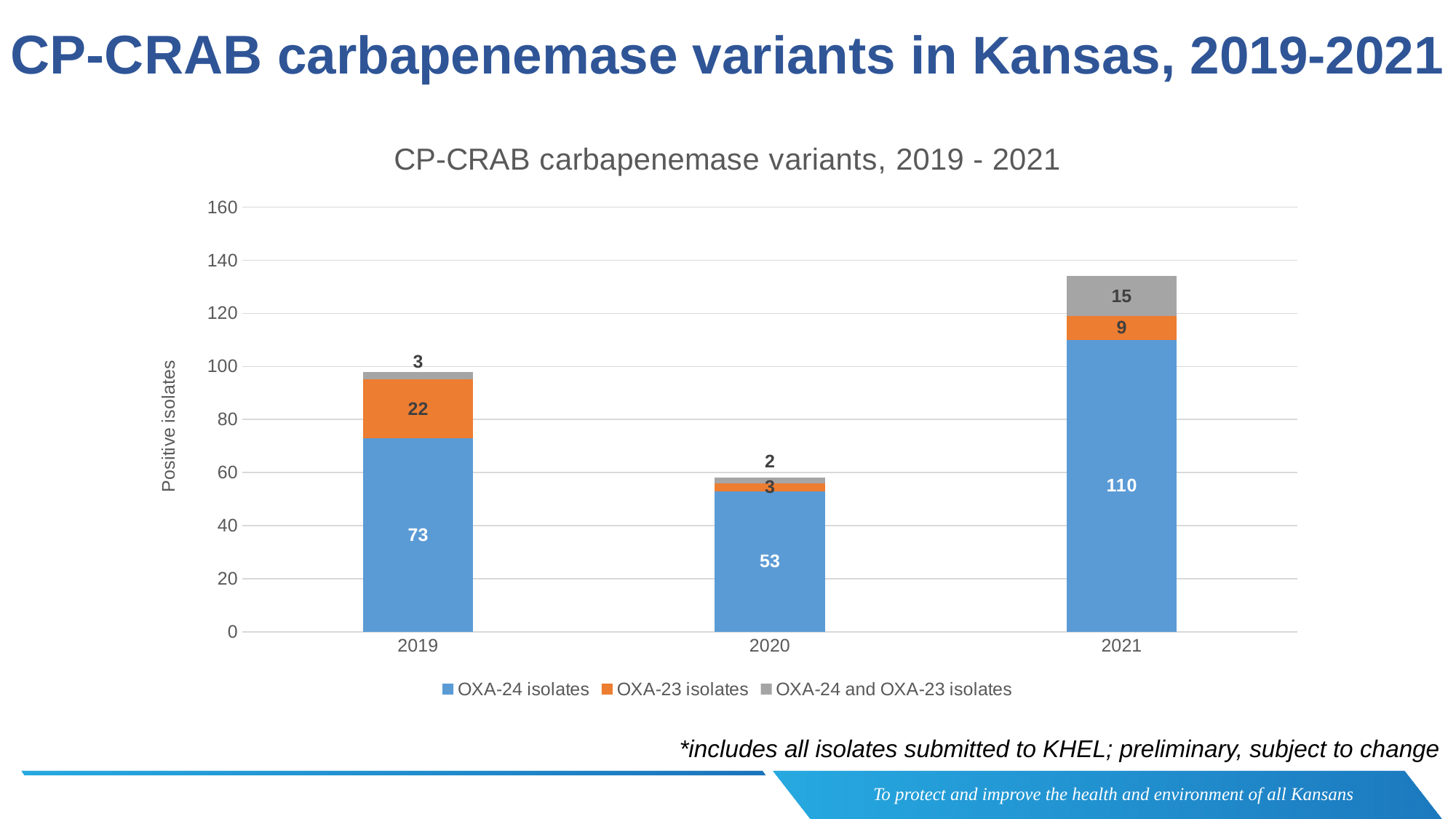
Which is larger: OXA-23 isolates in 2019 or OXA-23 isolates in 2021? OXA-23 isolates in 2019 Which year has the highest number of OXA-24 isolates? 2021 How many series does the legend list? 3 What kind of chart is shown? Stacked bar chart What is the value for OXA-24 and OXA-23 isolates in 2020? 2 What is the value for OXA-24 isolates in 2021? 110 What is the difference between OXA-24 isolates in 2021 and 2019? 37 What is the value for OXA-23 isolates in 2019? 22 What is the total of the stacked bar for 2020? 58 Which year has the lowest number of OXA-23 isolates? 2020 How many years are shown on the x axis? 3 What is the total of the stacked bar for 2021? 134